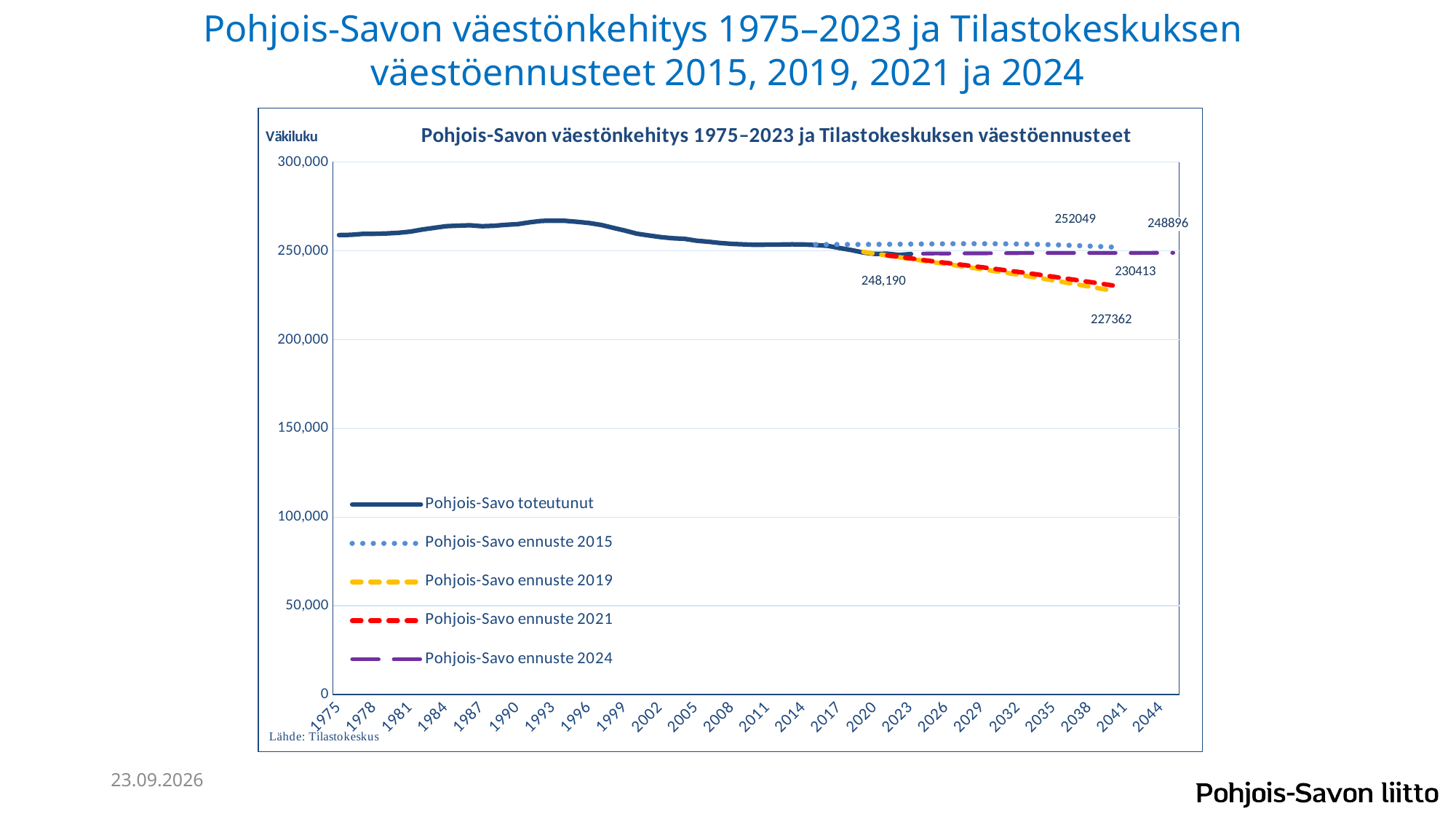
What kind of chart is shown on the slide? line chart What is the label on the vertical axis of the chart? Väkiluku Which forecast series ends at the lowest labelled value? Pohjois-Savo ennuste 2019 What is the labelled value of the Pohjois-Savo toteutunut series at its end in 2023? 248,190 What is the labelled end value of the Pohjois-Savo ennuste 2015 series? 252049 Is the value of the Pohjois-Savo toteutunut series in 1993 greater or less than 250,000? greater What is the difference between the labelled end values of ennuste 2015 (252049) and ennuste 2019 (227362)? 24687 What is the labelled end value of the Pohjois-Savo ennuste 2019 series? 227362 Which forecast series ends at the highest labelled value? Pohjois-Savo ennuste 2015 How many series does the legend list? 5 What is the labelled end value of the Pohjois-Savo ennuste 2021 series? 230413 What is the labelled end value of the Pohjois-Savo ennuste 2024 series? 248896